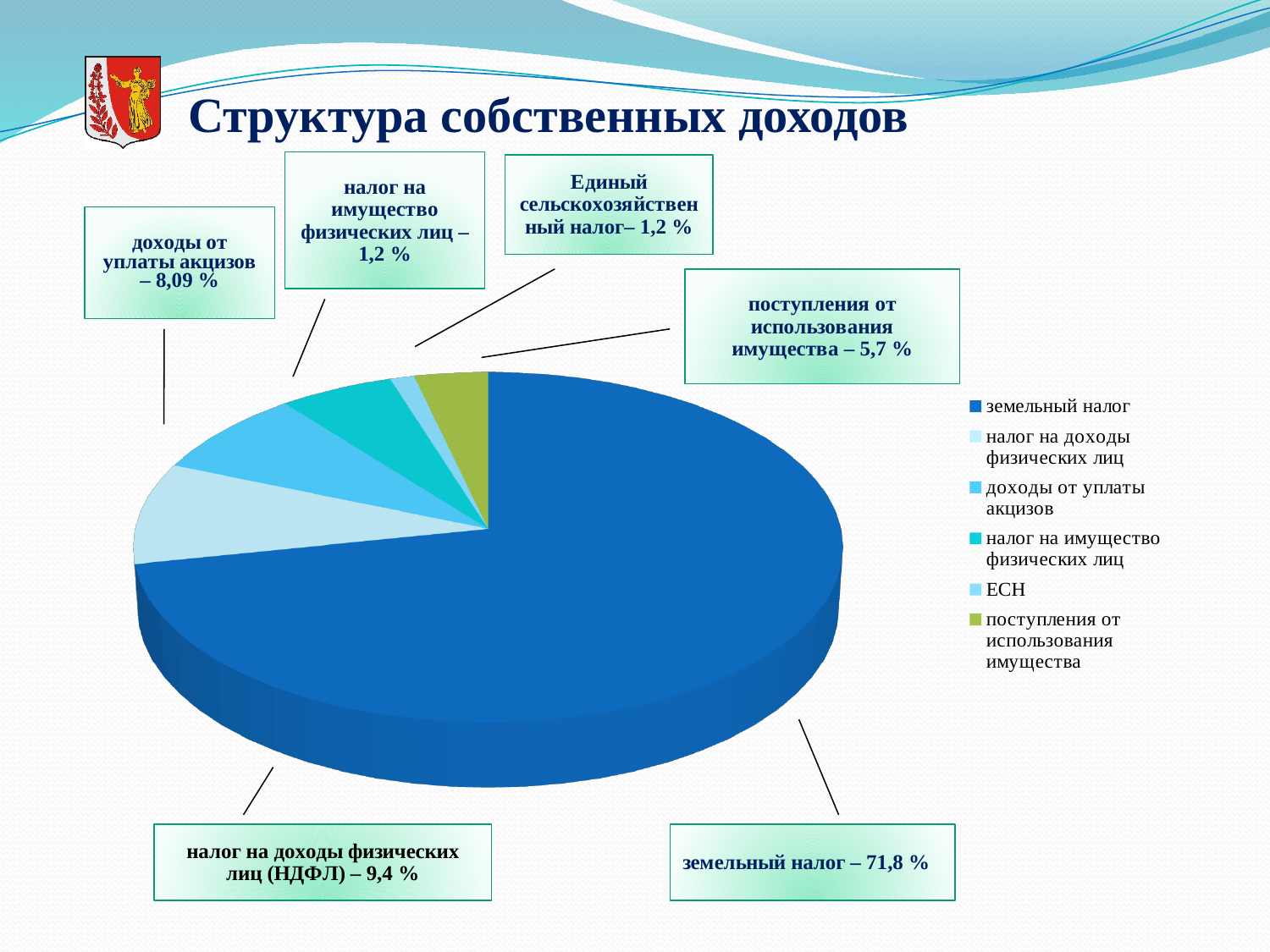
What share is given for доходы от уплаты акцизов? 8,09 % Which legend entry is shown in green? поступления от использования имущества How many entries does the legend list? 6 What share is given for налог на доходы физических лиц (НДФЛ)? 9,4 % Which is larger, the share for налог на доходы физических лиц or the share for доходы от уплаты акцизов? налог на доходы физических лиц What is the title of the slide's chart? Структура собственных доходов What share is given for поступления от использования имущества? 5,7 % What share is given for налог на имущество физических лиц? 1,2 % What kind of chart is shown on the slide? pie chart Which category has the largest slice of the pie? земельный налог What is the difference between the share for земельный налог and the share for налог на доходы физических лиц (НДФЛ)? 62,4 % What share does земельный налог have according to the callout? 71,8 %